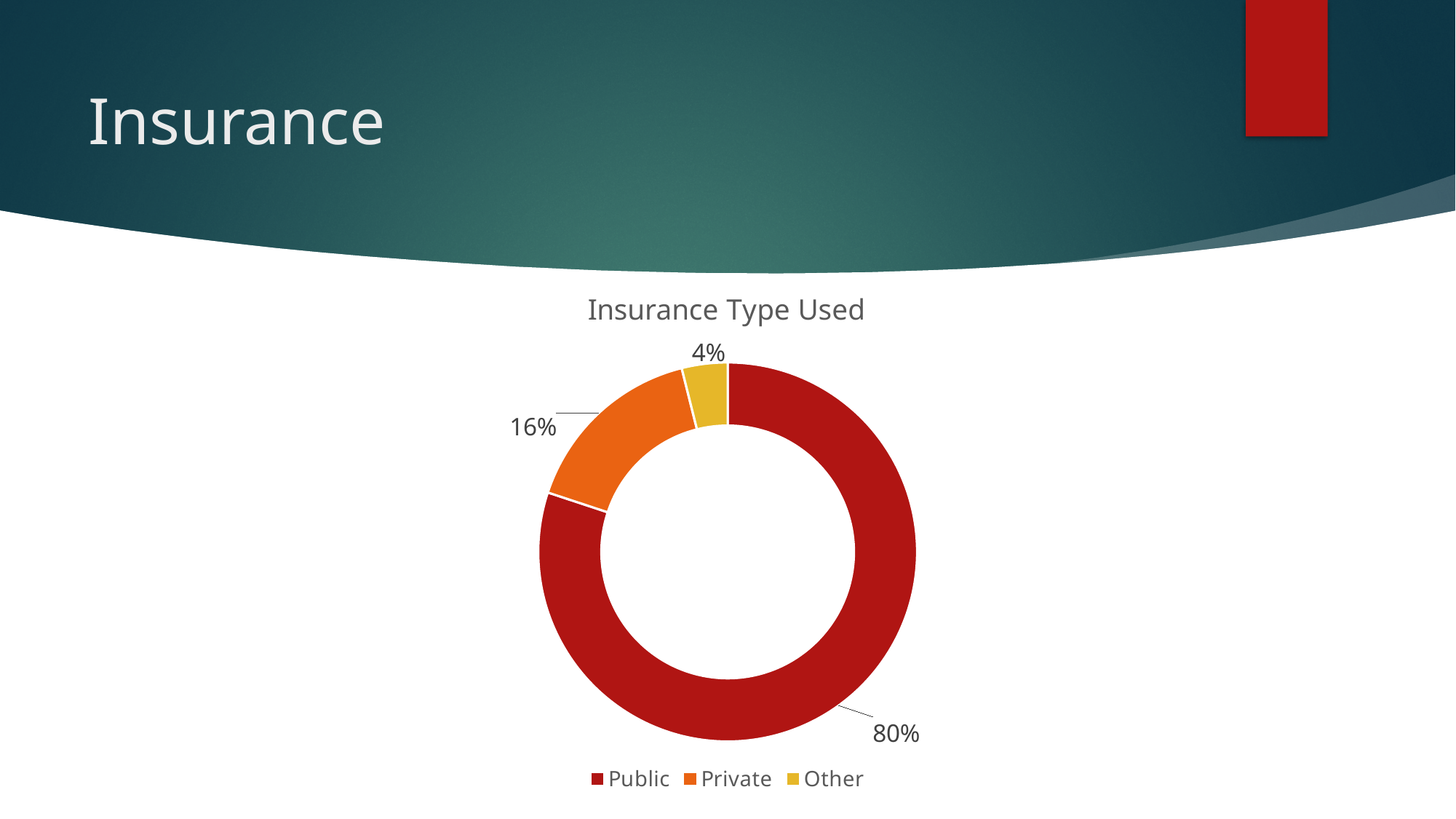
Which insurance type has the smallest share? Other What share of the chart does Other represent? 4% Which insurance type has the largest share? Public How many categories does the chart show? 3 What is the difference in percentage points between Private and Other? 12 What kind of chart is shown on the slide? Doughnut chart What is the difference in percentage points between Public and Private? 64 What share of the chart does Private represent? 16% Which is larger, the share for Private or the share for Other? Private What share of the chart does Public represent? 80% What is the title of the chart? Insurance Type Used Which colour represents Private in the legend? Orange